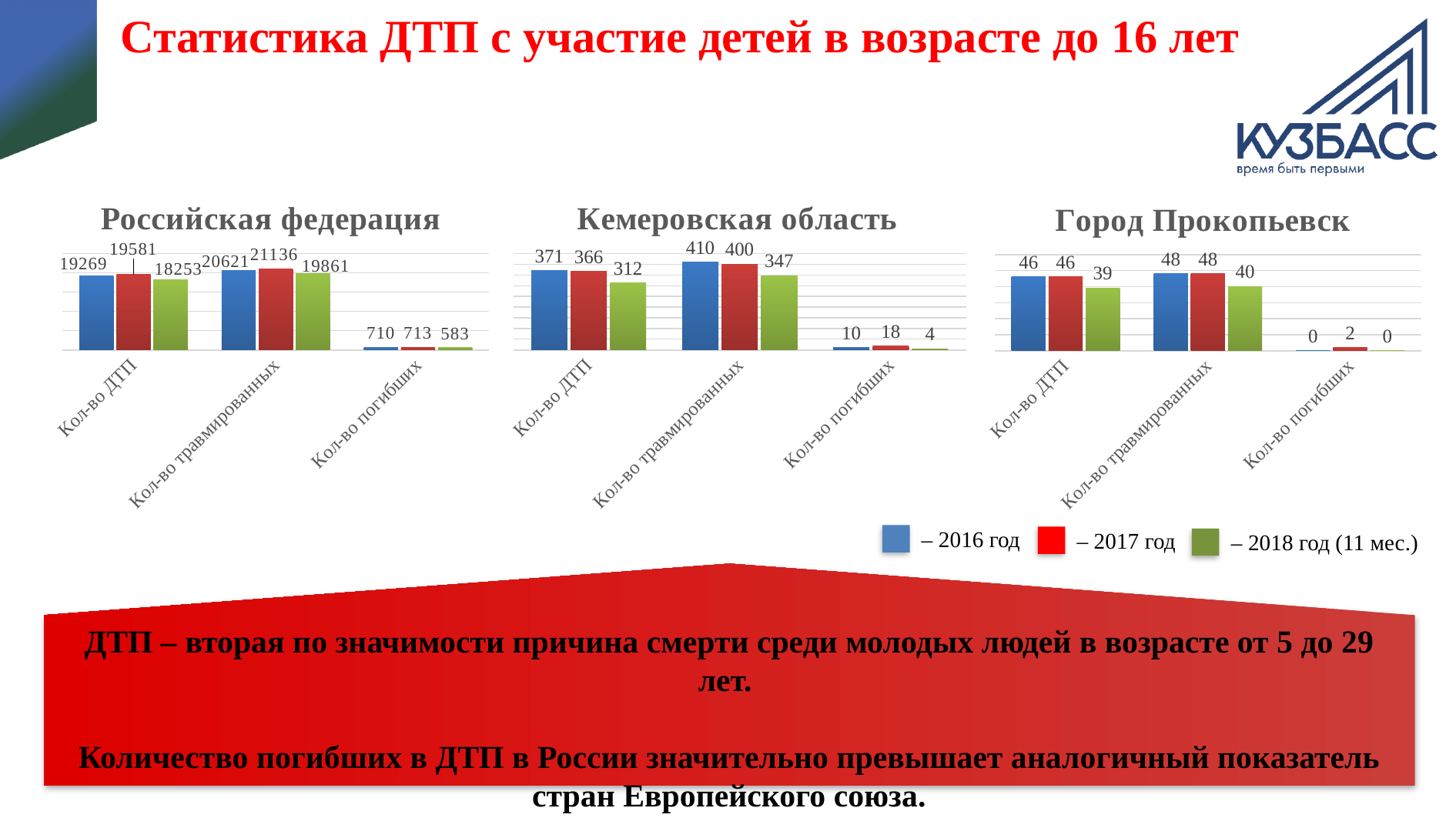
In the 'Российская федерация' chart, what is the value for 'Кол-во погибших' in 2018 (11 мес.)? 583 How many categories are shown on the x axis of the 'Кемеровская область' chart? 3 In the 'Город Прокопьевск' chart, what is the value for 'Кол-во погибших' in 2017? 2 In the 'Кемеровская область' chart, what is the value for 'Кол-во травмированных' in 2016? 410 In the 'Российская федерация' chart, what is the value for 'Кол-во ДТП' in 2017? 19581 How many series does the legend list? 3 In the 'Российская федерация' chart, which year has the lowest value for 'Кол-во травмированных'? 2018 (11 мес.) In the 'Российская федерация' chart, which is larger: 'Кол-во ДТП' in 2016 or 'Кол-во ДТП' in 2018? 2016 What type of chart is the 'Город Прокопьевск' chart? Bar chart In the 'Город Прокопьевск' chart, what is the difference between the 2017 and 2018 values for 'Кол-во травмированных'? 8 In the 'Кемеровская область' chart, which year has the highest value for 'Кол-во погибших'? 2017 In the 'Кемеровская область' chart, what is the difference between the 2016 and 2018 values for 'Кол-во ДТП'? 59